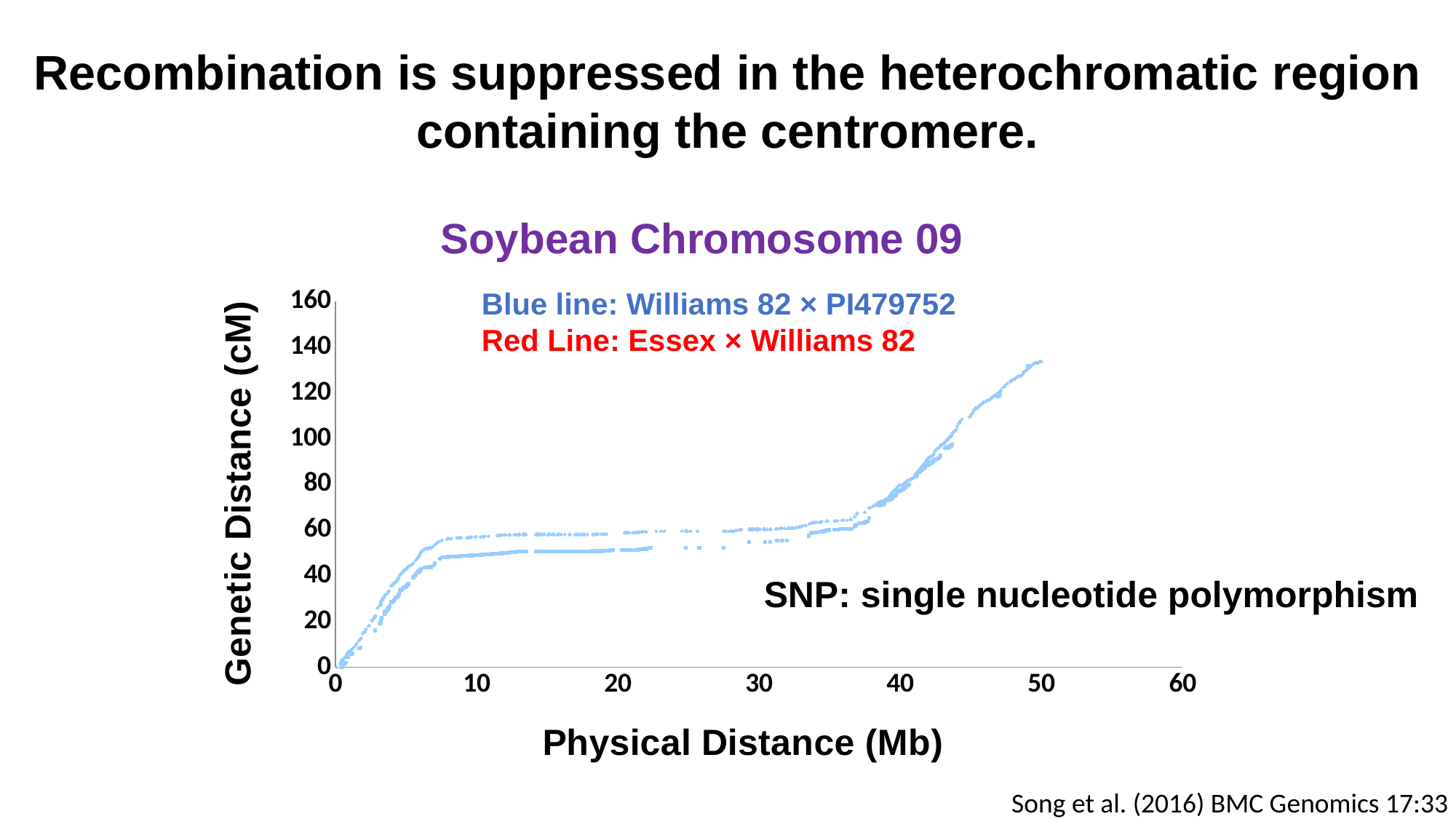
What kind of chart is shown on the slide? Scatter (line) chart Overall, does genetic distance rise or fall as physical distance increases along the x axis? Rises What is the highest tick value shown on the x axis? 60 What is the highest tick value shown on the y axis? 160 Is the genetic distance at a physical distance of 30 Mb greater or less than 100 cM? less How many series (lines) does the legend text list? 2 What is the label of the x axis? Physical Distance (Mb) What is the title of the chart? Soybean Chromosome 09 Which is larger: the genetic distance at 45 Mb or at 25 Mb? 45 Mb Is the genetic distance at a physical distance of 50 Mb greater or less than 120 cM? greater Is the genetic distance at a physical distance of 20 Mb greater or less than 80 cM? less